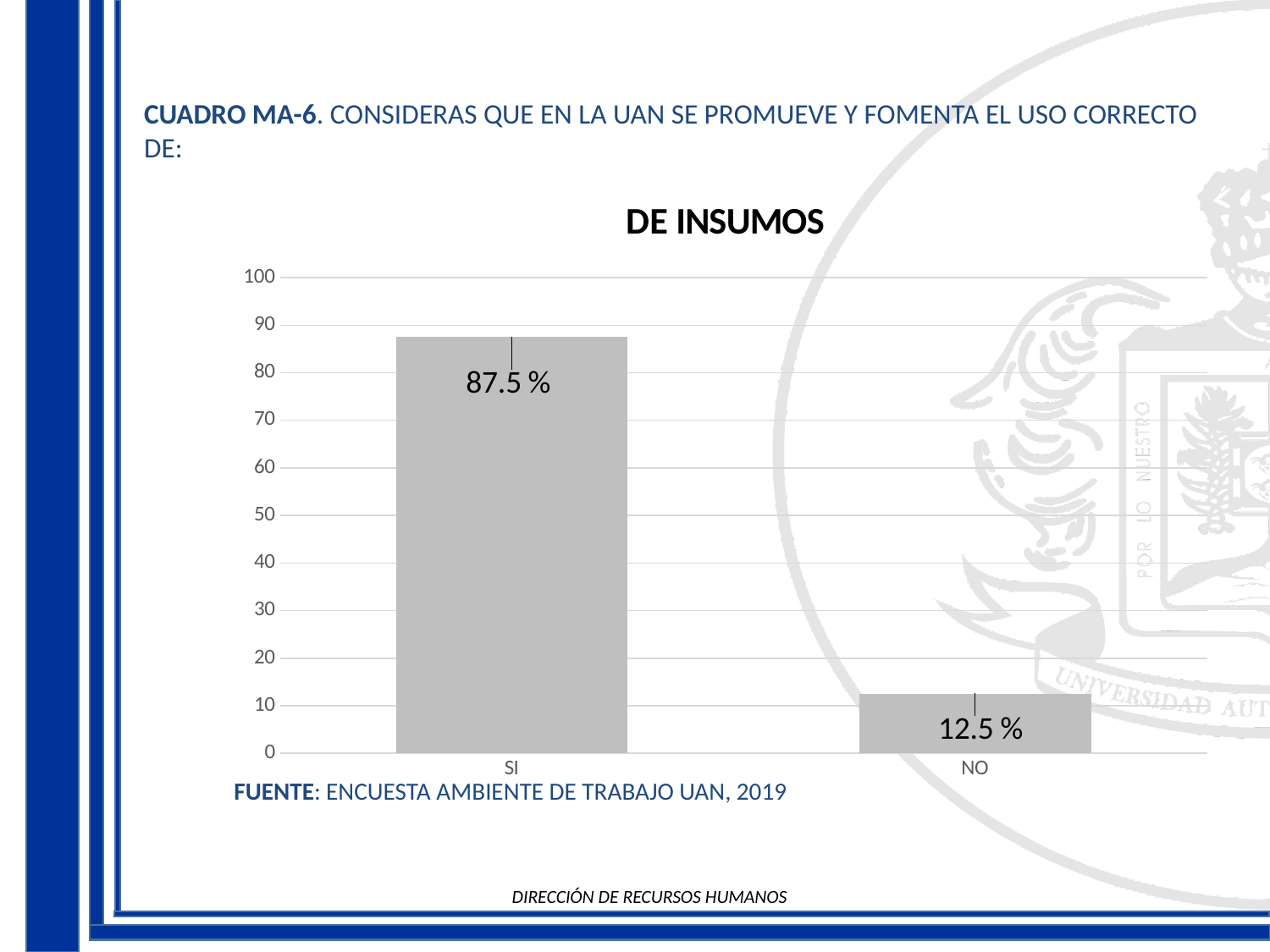
Which category has the lowest value? NO What is the value for NO? 12.5 % What is the title of the chart? DE INSUMOS What is the difference between the values for SI and NO? 75 % Which is larger, the value for SI or the value for NO? SI What is the value for SI? 87.5 % What kind of chart is shown on the slide? bar chart How many categories are shown on the x axis? 2 Is the value for NO greater or less than 20? less Is the value for SI greater or less than 80? greater What is the maximum value shown on the y axis? 100 Which category has the highest value? SI